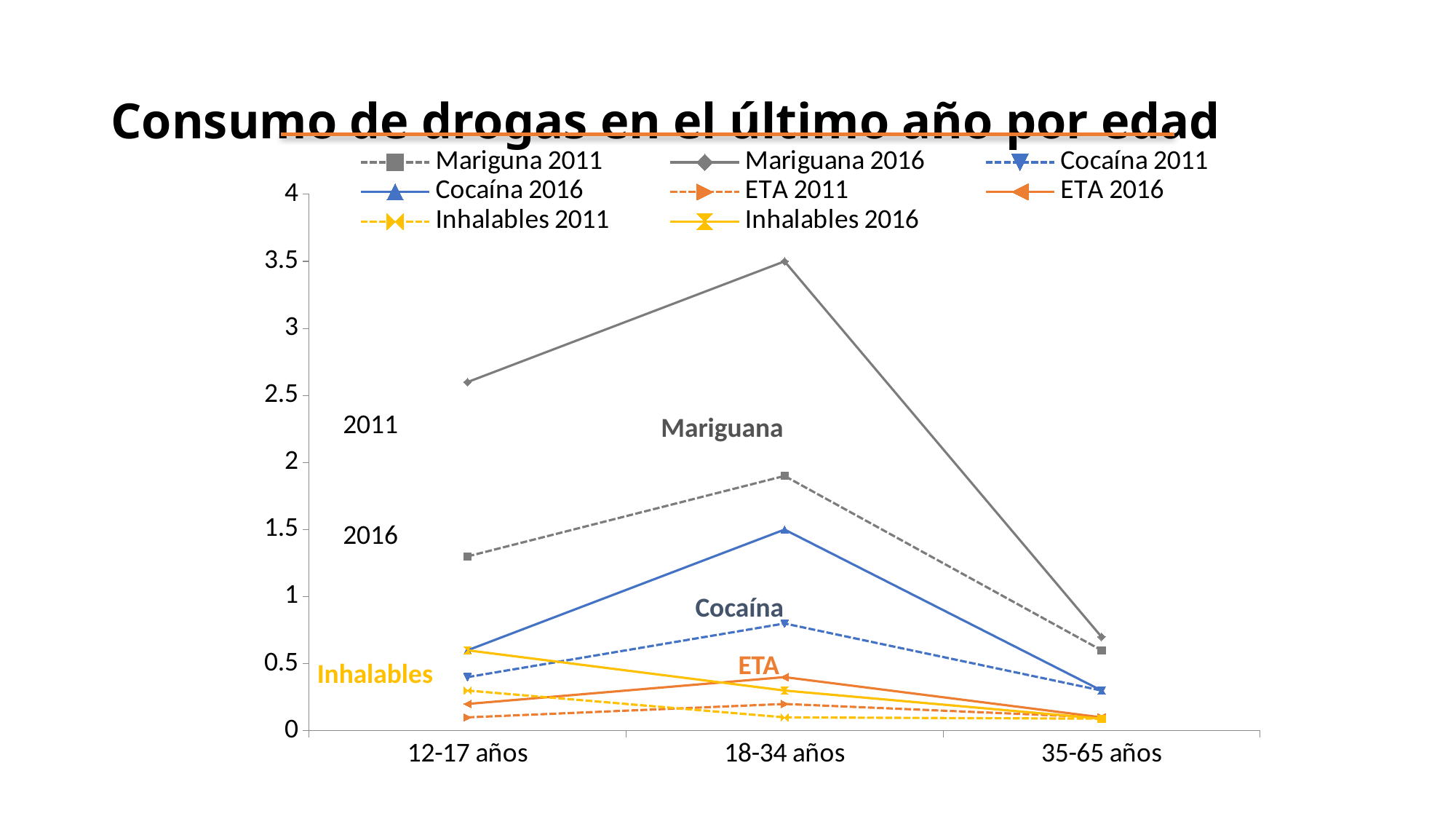
What kind of chart is shown on the slide? line chart In the 18-34 años category, which is larger: Mariguana 2016 or Mariguana 2011? Mariguana 2016 Which series reaches the highest value on the chart? Mariguana 2016 Is the value for Mariguana 2016 in the 35-65 años category greater or less than 1? less How many series does the legend list? 8 Which age category has the highest value for Mariguana 2016? 18-34 años Is the value for Cocaína 2011 in the 18-34 años category greater or less than 1? less What is the title of the chart? Consumo de drogas en el último año por edad How many age categories are shown on the x axis? 3 What is the value for Cocaína 2016 in the 18-34 años category? 1.5 What is the value for Mariguana 2016 in the 18-34 años category? 3.5 Is the value for Mariguana 2016 in the 12-17 años category greater or less than 2? greater